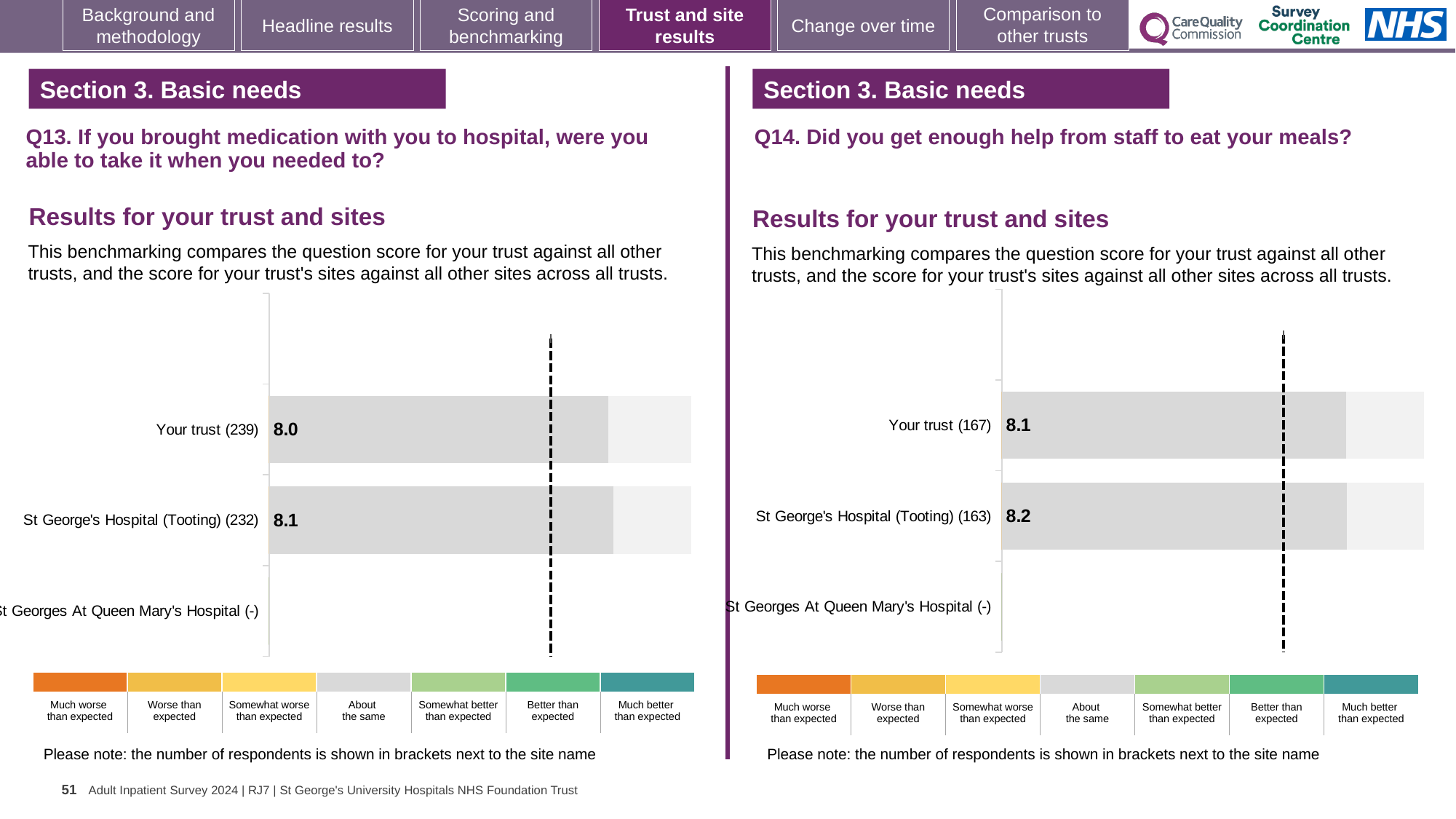
How many benchmark bands are shown in the colour key below the Q14 chart on the right? 7 In the Q13 chart on the left, how many respondents are shown in brackets for Your trust? 239 In the Q13 chart on the left, which is larger: the score for Your trust or for St George's Hospital (Tooting)? St George's Hospital (Tooting) In the Q14 chart on the right, what is the score for St George's Hospital (Tooting)? 8.2 How many categories are listed on the vertical axis of the Q13 chart on the left? 3 In the Q13 chart on the left, what is the score for St George's Hospital (Tooting)? 8.1 In the Q14 chart on the right, what is the score for Your trust? 8.1 What kind of chart is the Q14 chart on the right? Bar chart In the Q14 chart on the right, what is the difference between the score for St George's Hospital (Tooting) and the score for Your trust? 0.1 In the Q14 chart on the right, how many respondents are shown in brackets for St George's Hospital (Tooting)? 163 In the Q13 chart on the left, what is the score for Your trust? 8.0 In the Q13 chart on the left, which category has no score shown? St Georges At Queen Mary's Hospital (-)